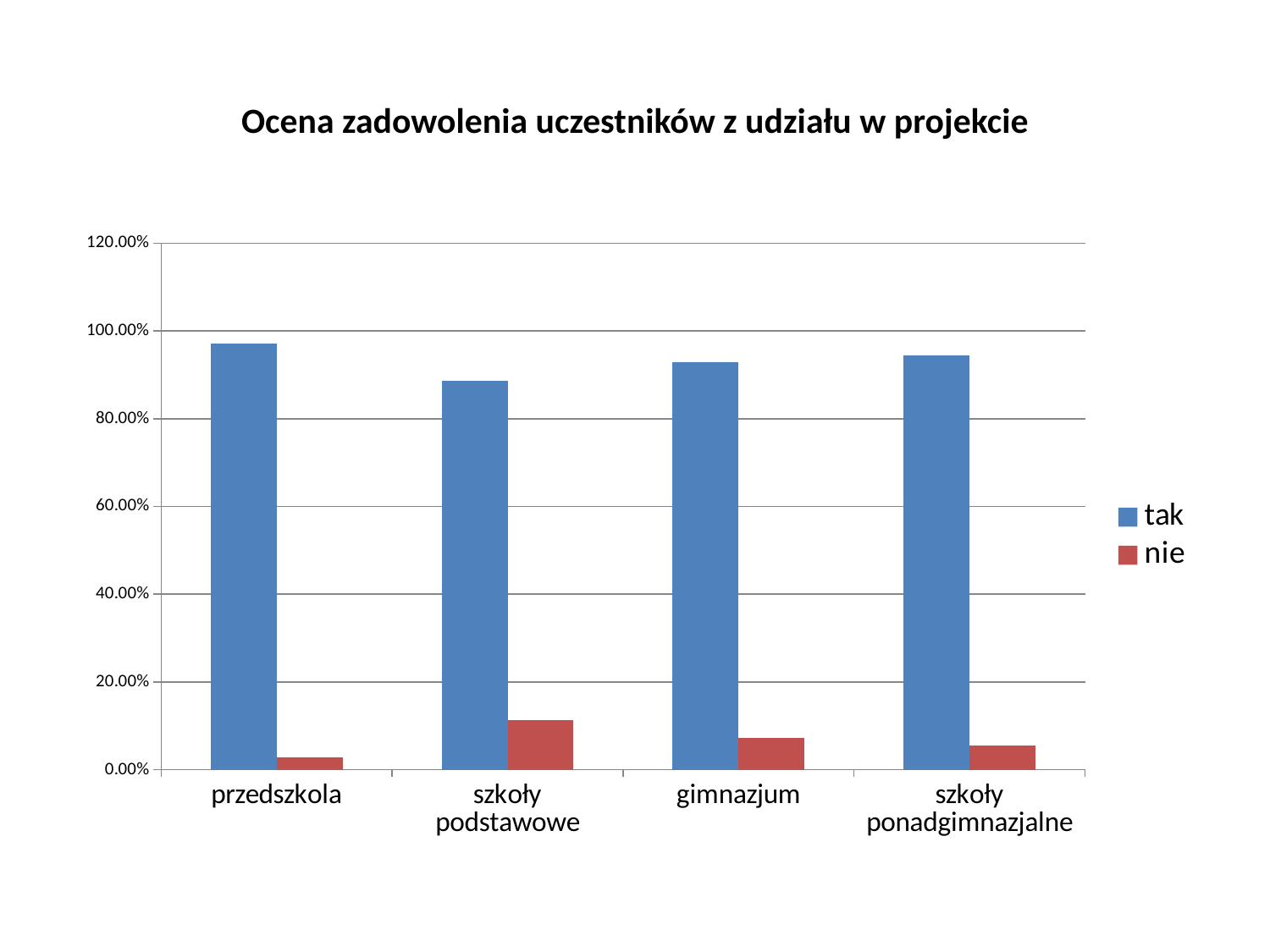
What kind of chart is shown on the slide? bar chart How many categories are shown on the x axis? 4 Which category has the lowest value for the 'nie' series? przedszkola Which category has the lowest value for the 'tak' series? szkoły podstawowe What is the title of the chart? Ocena zadowolenia uczestników z udziału w projekcie Is the 'tak' value for szkoły podstawowe greater or less than 80.00%? greater Which is larger: the 'tak' value for gimnazjum or the 'tak' value for szkoły podstawowe? gimnazjum Which category has the highest value for the 'tak' series? przedszkola Which colour represents the 'nie' series in the legend? red Which category has the highest value for the 'nie' series? szkoły podstawowe Is the 'nie' value for szkoły podstawowe greater or less than 20.00%? less How many series does the legend list? 2